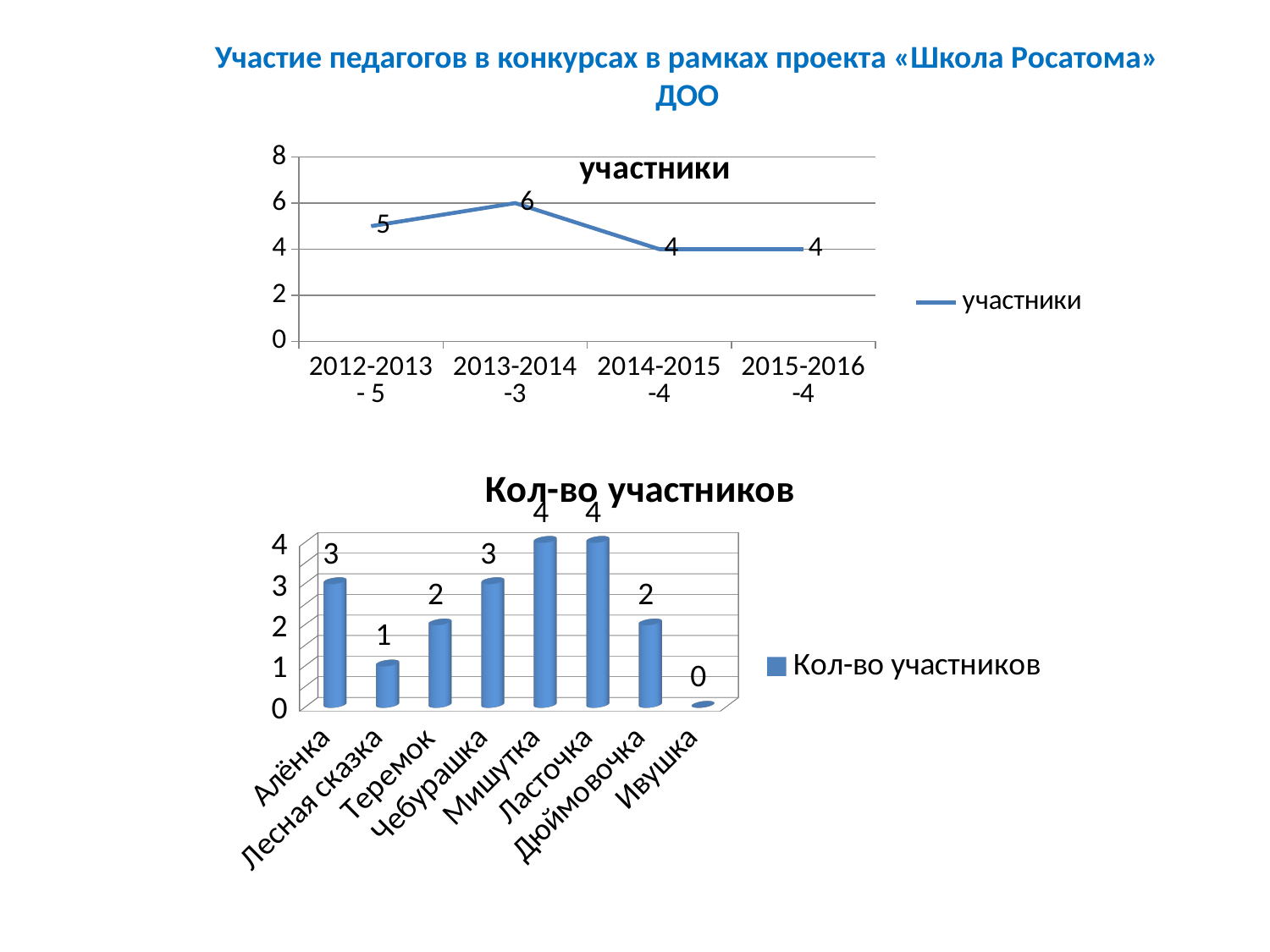
In the top chart titled «участники», what is the difference between the values for 2013-2014 and 2014-2015? 2 In the bottom chart titled «Кол-во участников», which is larger, the value for Алёнка or the value for Лесная сказка? Алёнка In the bottom chart titled «Кол-во участников», how many categories are shown? 8 In the bottom chart titled «Кол-во участников», which category has the lowest value? Ивушка What kind of chart is the top chart titled «участники»? line chart In the top chart titled «участники», what is the value for 2012-2013? 5 In the top chart titled «участники», which period has the highest value? 2013-2014 What kind of chart is the bottom chart titled «Кол-во участников»? bar chart In the bottom chart titled «Кол-во участников», what is the value for Теремок? 2 In the top chart titled «участники», how many data points are plotted? 4 In the bottom chart titled «Кол-во участников», what is the difference between the values for Мишутка and Дюймовочка? 2 In the top chart titled «участники», what is the value for 2013-2014? 6